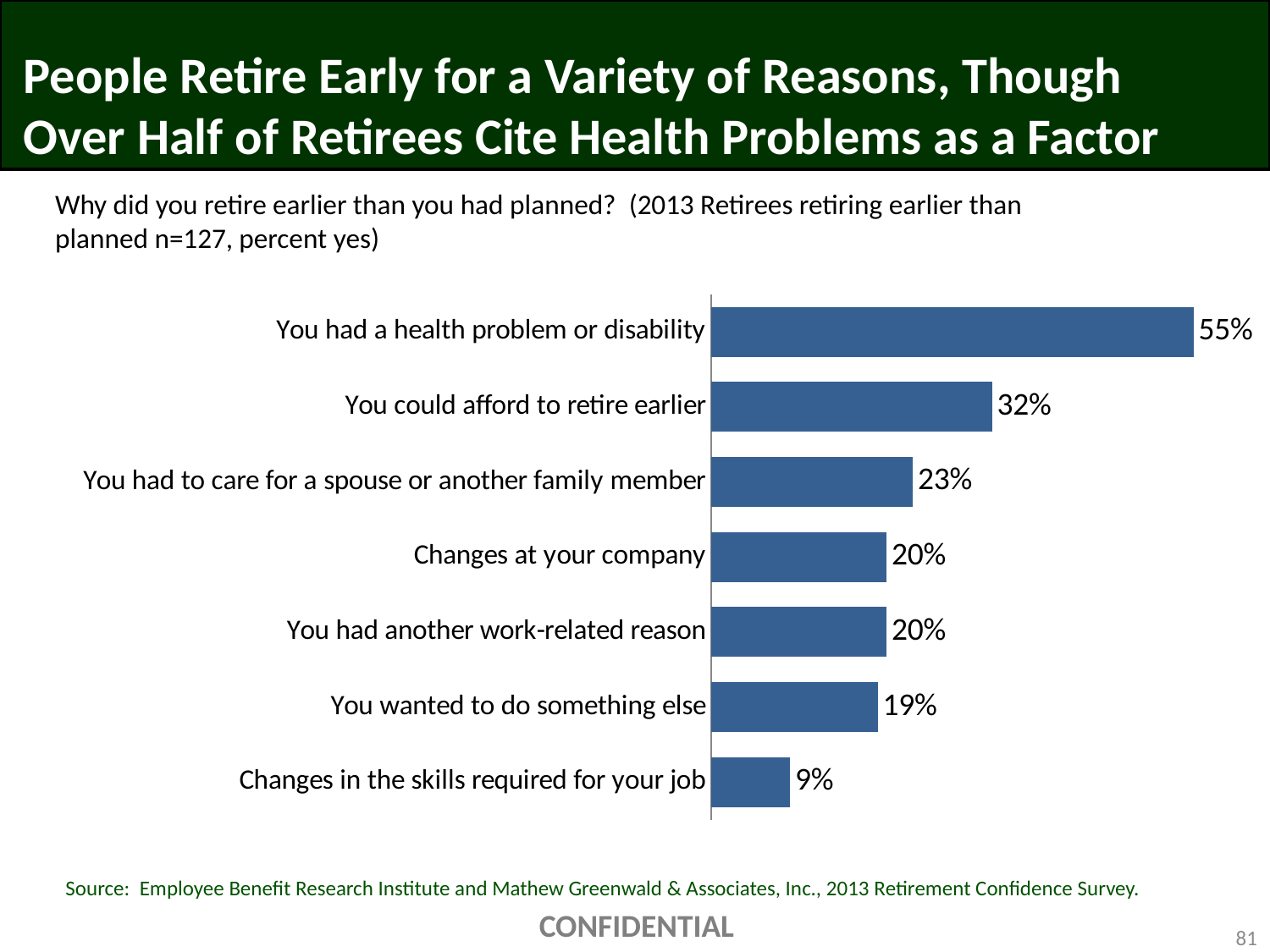
Which is larger: the value for 'You wanted to do something else' or the value for 'You had to care for a spouse or another family member'? You had to care for a spouse or another family member Which reason has the lowest percentage in the chart? Changes in the skills required for your job What is the sample size (n) stated in the chart's subtitle? 127 Which reason has the highest percentage in the chart? You had a health problem or disability What percentage is shown for 'Changes in the skills required for your job'? 9% Which two reasons share the same value of 20%? Changes at your company; You had another work-related reason What is the value for 'You had to care for a spouse or another family member'? 23% What percentage of retirees said 'You could afford to retire earlier'? 32% What kind of chart is shown on the slide? Bar chart What percentage of retirees cited 'You had a health problem or disability' as a reason for retiring earlier than planned? 55% What is the difference in percentage points between 'You had a health problem or disability' and 'You could afford to retire earlier'? 23 How many reasons (categories) are shown in the chart? 7